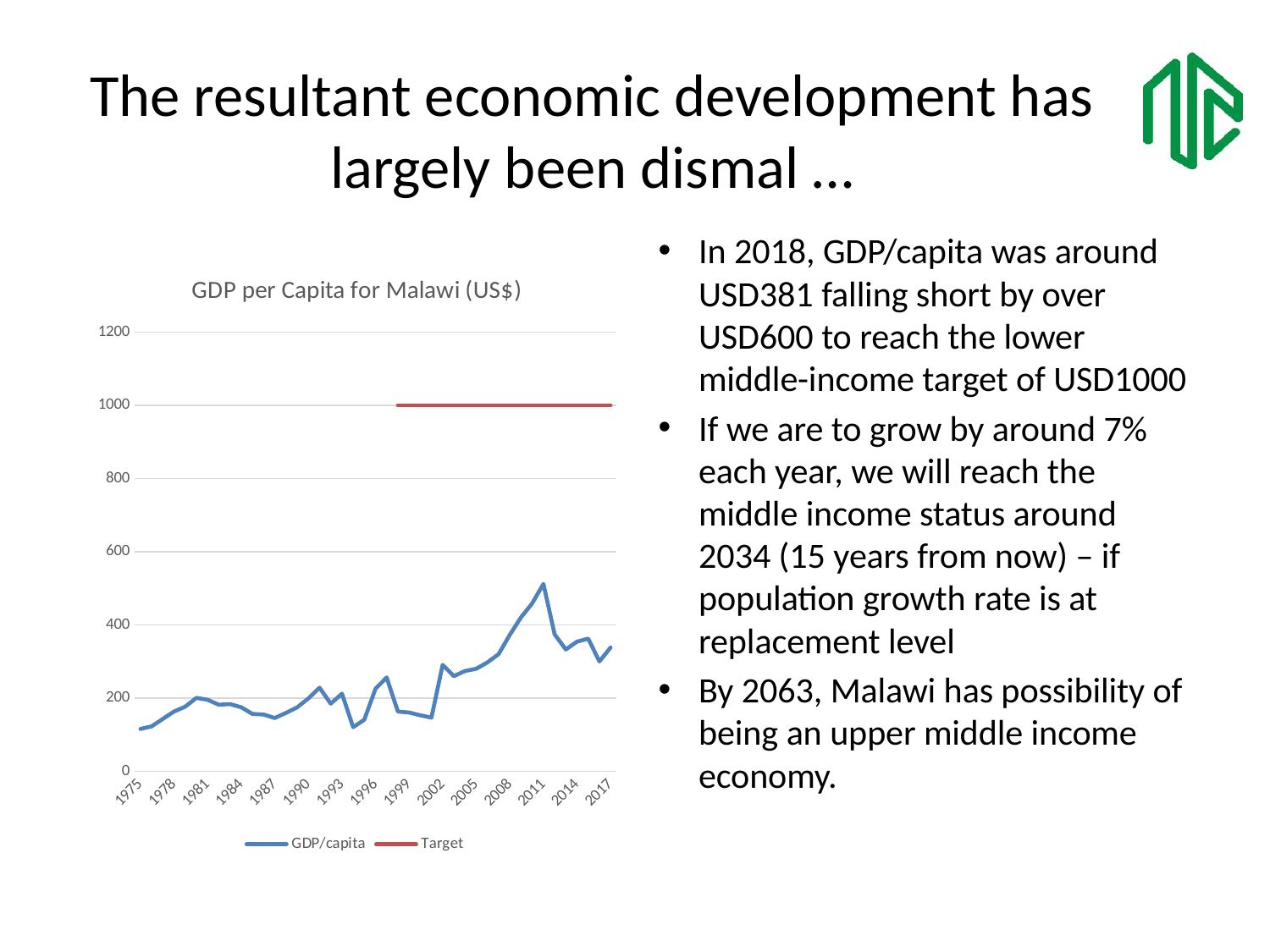
What kind of chart is shown on the slide? line chart Is the GDP/capita value for 2011 greater or less than 400? greater What is the highest value labelled on the chart's y axis? 1200 In 2017, which series has the larger value, GDP/capita or Target? Target What are the two series named in the chart legend? GDP/capita and Target Is the GDP/capita value for 2017 greater or less than 600? less How many year labels are shown on the x axis of the chart? 15 Is the GDP/capita value for 1975 greater or less than 200? less How many series does the chart legend list? 2 What is the title of the chart? GDP per Capita for Malawi (US$) Does the GDP/capita line overall rise or fall between 1975 and 2017? rise What value does the Target line sit at on the chart? 1000